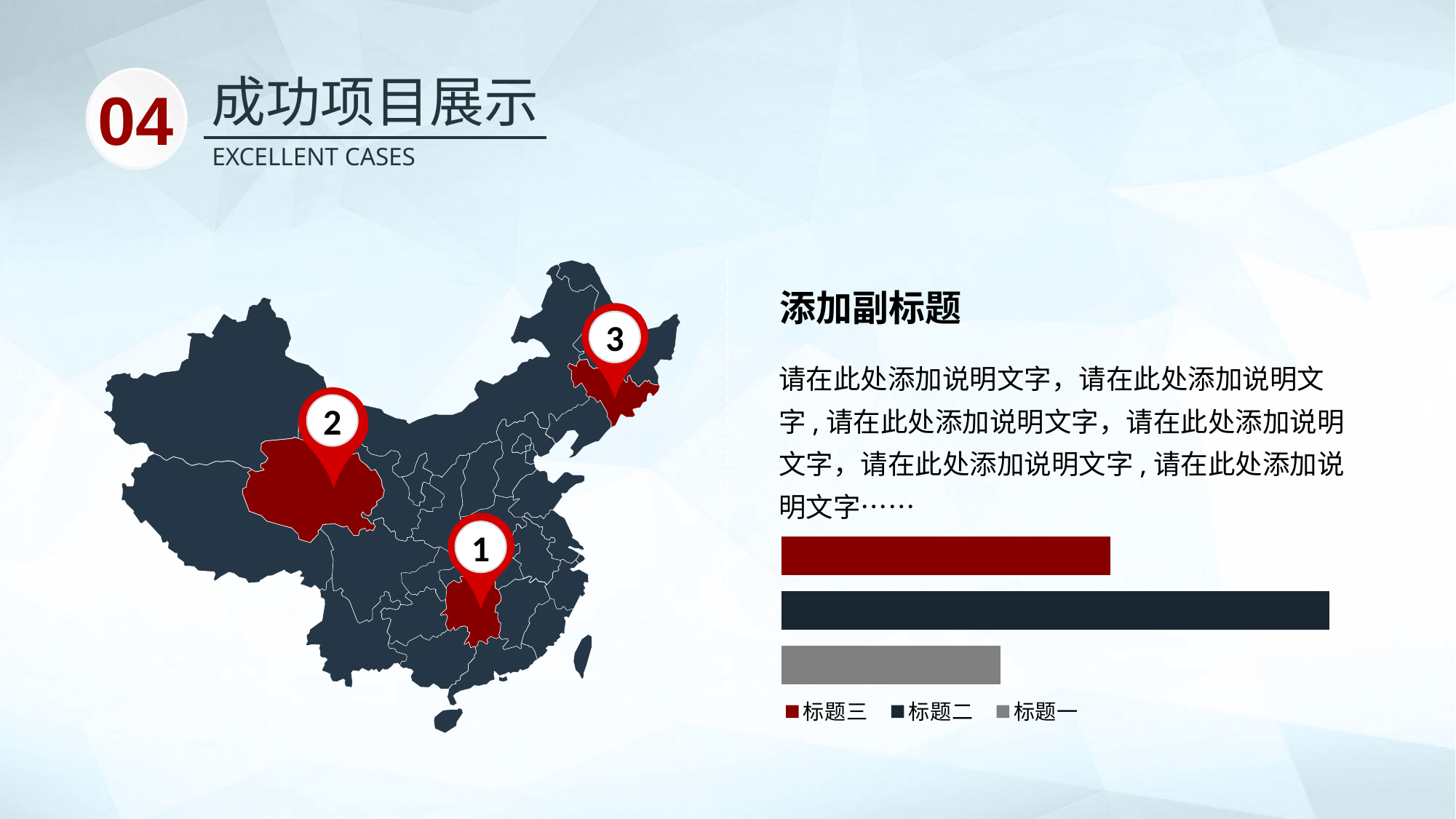
What colour is the bar for 标题三 in the bar chart? dark red Which series has the longest bar in the bar chart? 标题二 How many bars are plotted in the bar chart? 3 In the bar chart, which bar is longer: 标题二 or 标题三? 标题二 How many series does the legend of the bar chart list? 3 What colour is the bar for 标题一 in the bar chart? gray In the bar chart, which bar is longer: 标题三 or 标题一? 标题三 Which series has the shortest bar in the bar chart? 标题一 What kind of chart is shown on the right side of the slide? bar chart